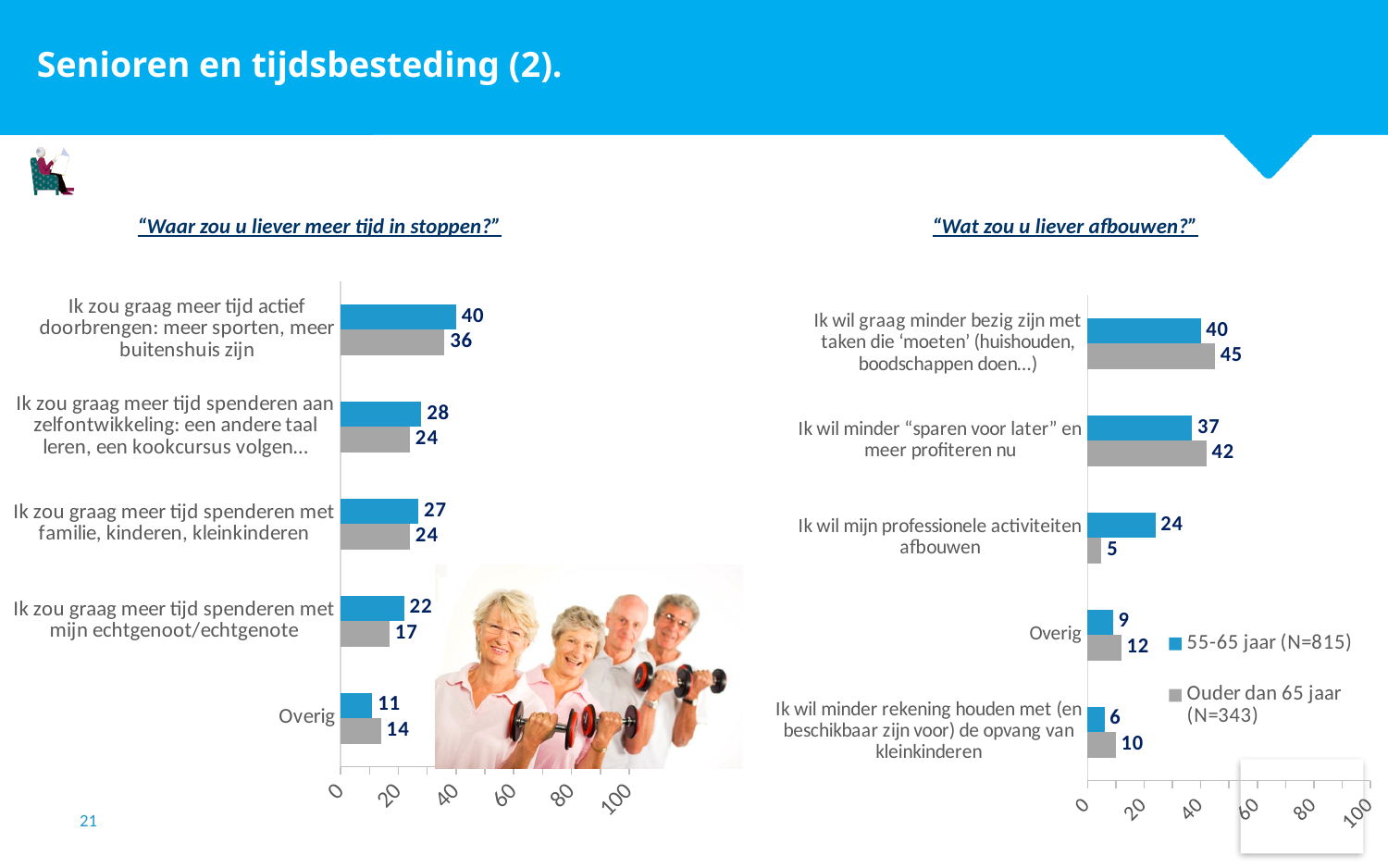
In the chart "Waar zou u liever meer tijd in stoppen?", what is the value for "Overig" for the 55-65 jaar (blue) series? 11 In the chart "Wat zou u liever afbouwen?", which category has the lowest 55-65 jaar (N=815) value? Ik wil minder rekening houden met (en beschikbaar zijn voor) de opvang van kleinkinderen In the chart "Waar zou u liever meer tijd in stoppen?", what is the grey (Ouder dan 65 jaar) value for "Ik zou graag meer tijd spenderen met mijn echtgenoot/echtgenote"? 17 In the chart "Wat zou u liever afbouwen?", which is larger for "Ik wil graag minder bezig zijn met taken die 'moeten'": the 55-65 jaar value or the Ouder dan 65 jaar value? Ouder dan 65 jaar In the chart "Waar zou u liever meer tijd in stoppen?", what is the difference between the blue and grey values for "Ik zou graag meer tijd spenderen aan zelfontwikkeling"? 4 In the chart "Waar zou u liever meer tijd in stoppen?", how many categories are shown? 5 How many series does the legend of the chart "Wat zou u liever afbouwen?" list? 2 In the chart "Wat zou u liever afbouwen?", what is the difference between the 55-65 jaar and Ouder dan 65 jaar values for "Ik wil mijn professionele activiteiten afbouwen"? 19 In the chart "Wat zou u liever afbouwen?", what is the value for "Ik wil mijn professionele activiteiten afbouwen" for Ouder dan 65 jaar (N=343)? 5 In the chart "Waar zou u liever meer tijd in stoppen?", which category has the highest blue (55-65 jaar) value? Ik zou graag meer tijd actief doorbrengen: meer sporten, meer buitenshuis zijn What type of chart is "Wat zou u liever afbouwen?"? Bar chart In the chart "Wat zou u liever afbouwen?", what is the 55-65 jaar (N=815) value for "Ik wil minder 'sparen voor later' en meer profiteren nu"? 37